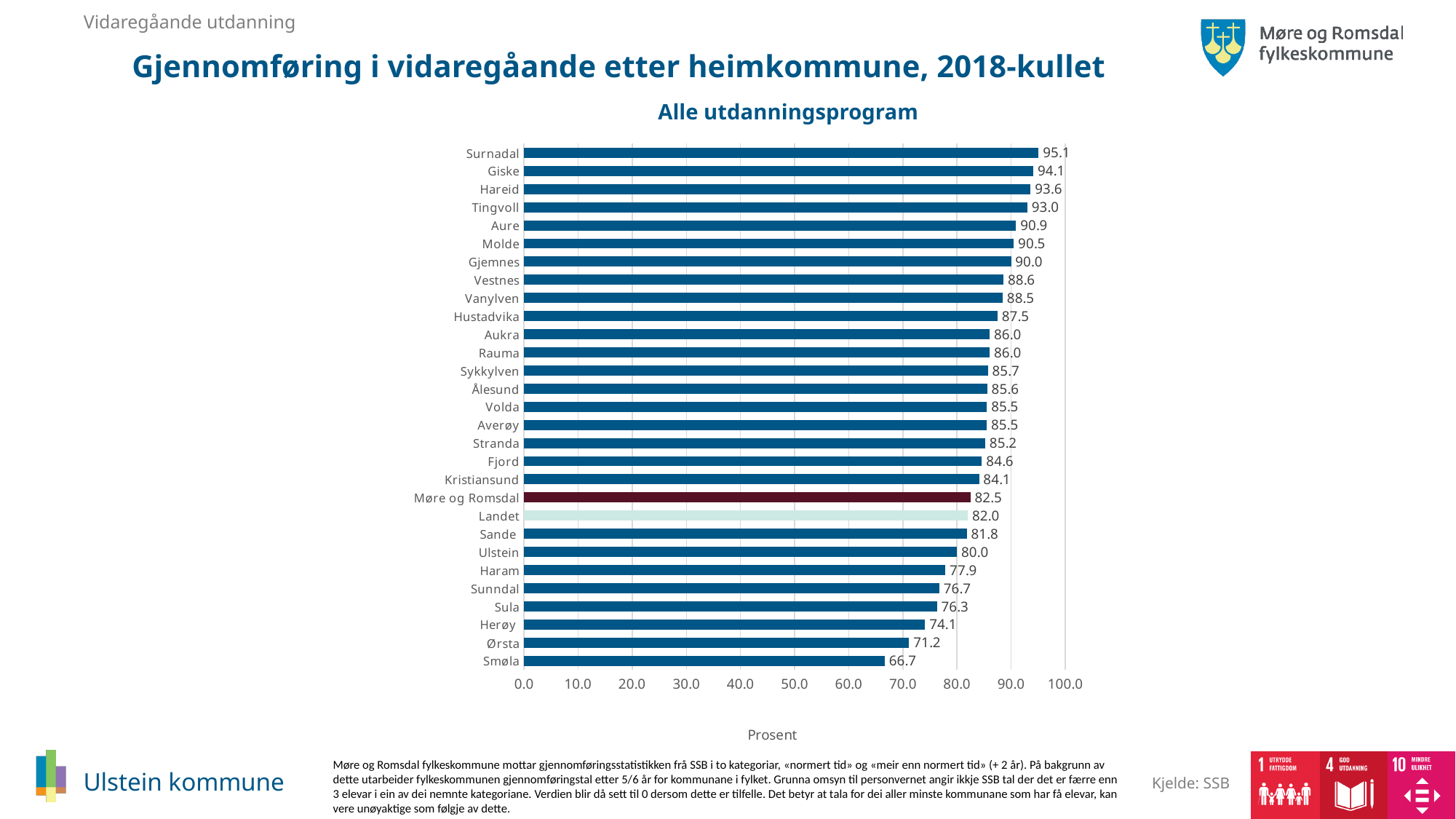
What is the difference between the values for Møre og Romsdal and Ulstein? 2.5 What is the value for Landet? 82.0 What kind of chart is shown on the slide? bar chart Which is larger, the value for Giske or the value for Hareid? Giske What is the value for Møre og Romsdal? 82.5 What is the value for Ulstein? 80.0 How many categories are shown in the chart? 29 Is the value for Herøy greater or less than 80.0? less Which category has the lowest value? Smøla Which category has the highest value? Surnadal What is the title shown above the chart? Alle utdanningsprogram What is the difference between the values for Surnadal and Smøla? 28.4